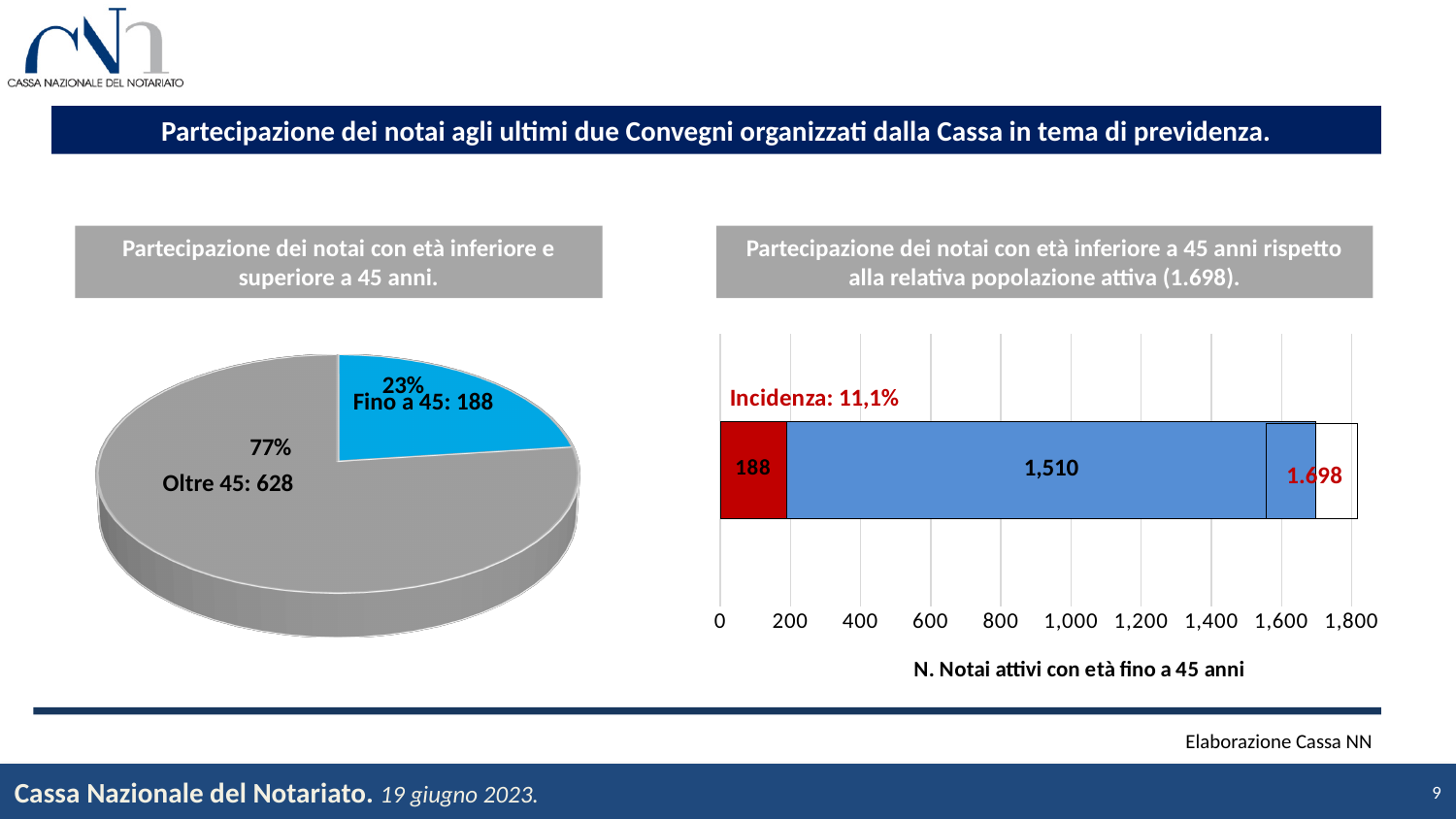
What kind of chart is shown on the right of the slide? Bar chart In the left pie chart, what value is shown for 'Fino a 45'? 188 In the left pie chart, which category has the larger value, 'Fino a 45' or 'Oltre 45'? Oltre 45 In the left pie chart, what percentage share does the 'Oltre 45' slice have? 77% In the left pie chart, what percentage share does the 'Fino a 45' slice have? 23% In the right bar chart, what is the total of the stacked bar? 1.698 In the right bar chart, what value is shown in the red segment? 188 What kind of chart is shown on the left of the slide? Pie chart In the right bar chart, what is the label of the horizontal axis? N. Notai attivi con età fino a 45 anni In the left pie chart, what is the difference between the 'Oltre 45' value and the 'Fino a 45' value? 440 In the left pie chart, what value is shown for 'Oltre 45'? 628 In the right bar chart, what value is shown in the blue segment? 1,510